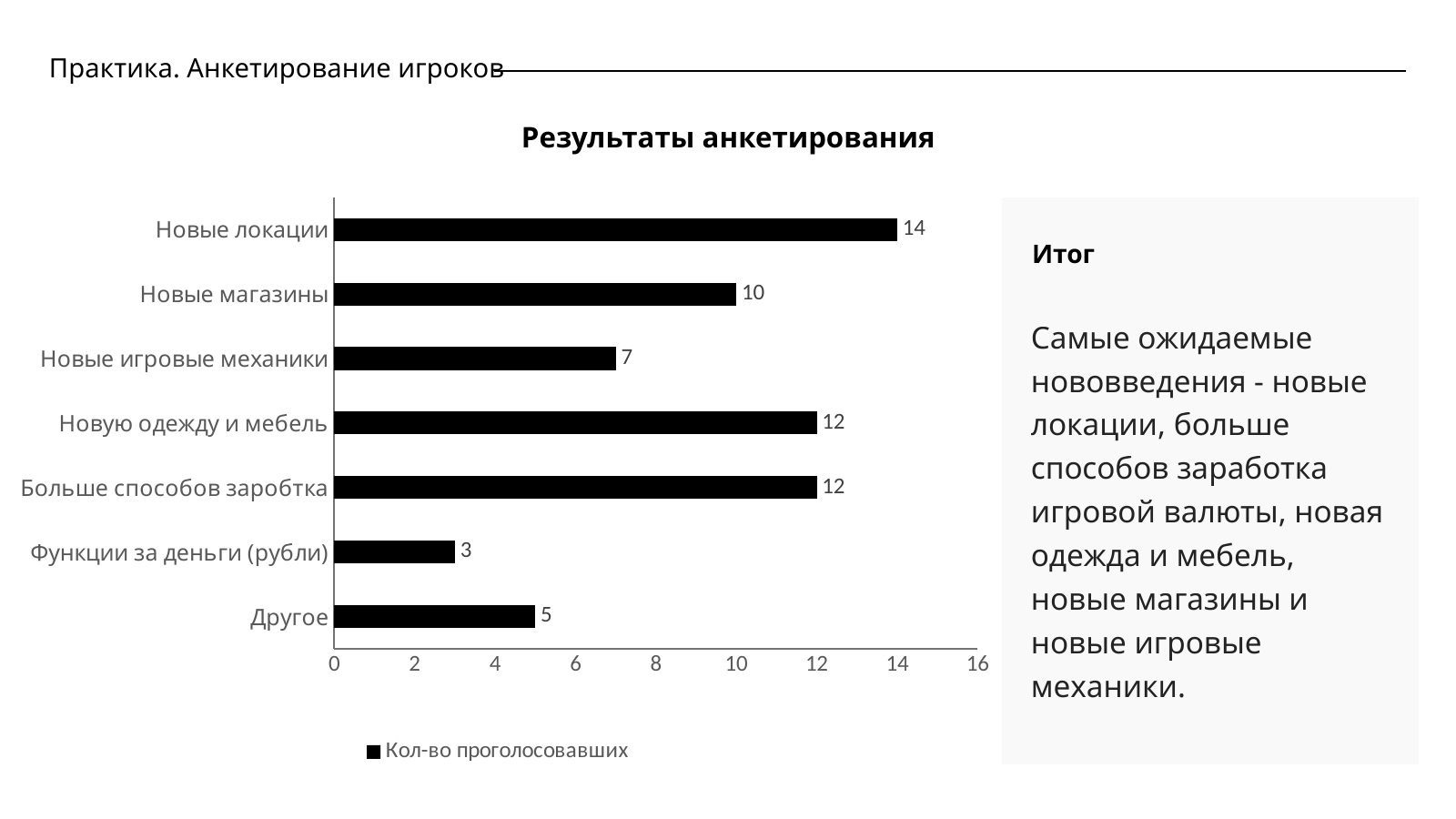
Which is larger, the value for Другое or the value for Новые игровые механики? Новые игровые механики What is the value for Функции за деньги (рубли)? 3 How many series does the legend list? 1 What is the value for Новые игровые механики? 7 What is the title of the chart? Результаты анкетирования What is the difference between the values for Новые локации and Новые магазины? 4 Is the value for Новую одежду и мебель greater or less than 10? greater What kind of chart is shown on the slide? bar chart Which category has the highest value? Новые локации What is the value for Новые локации? 14 How many categories are shown in the chart? 7 Which category has the lowest value? Функции за деньги (рубли)